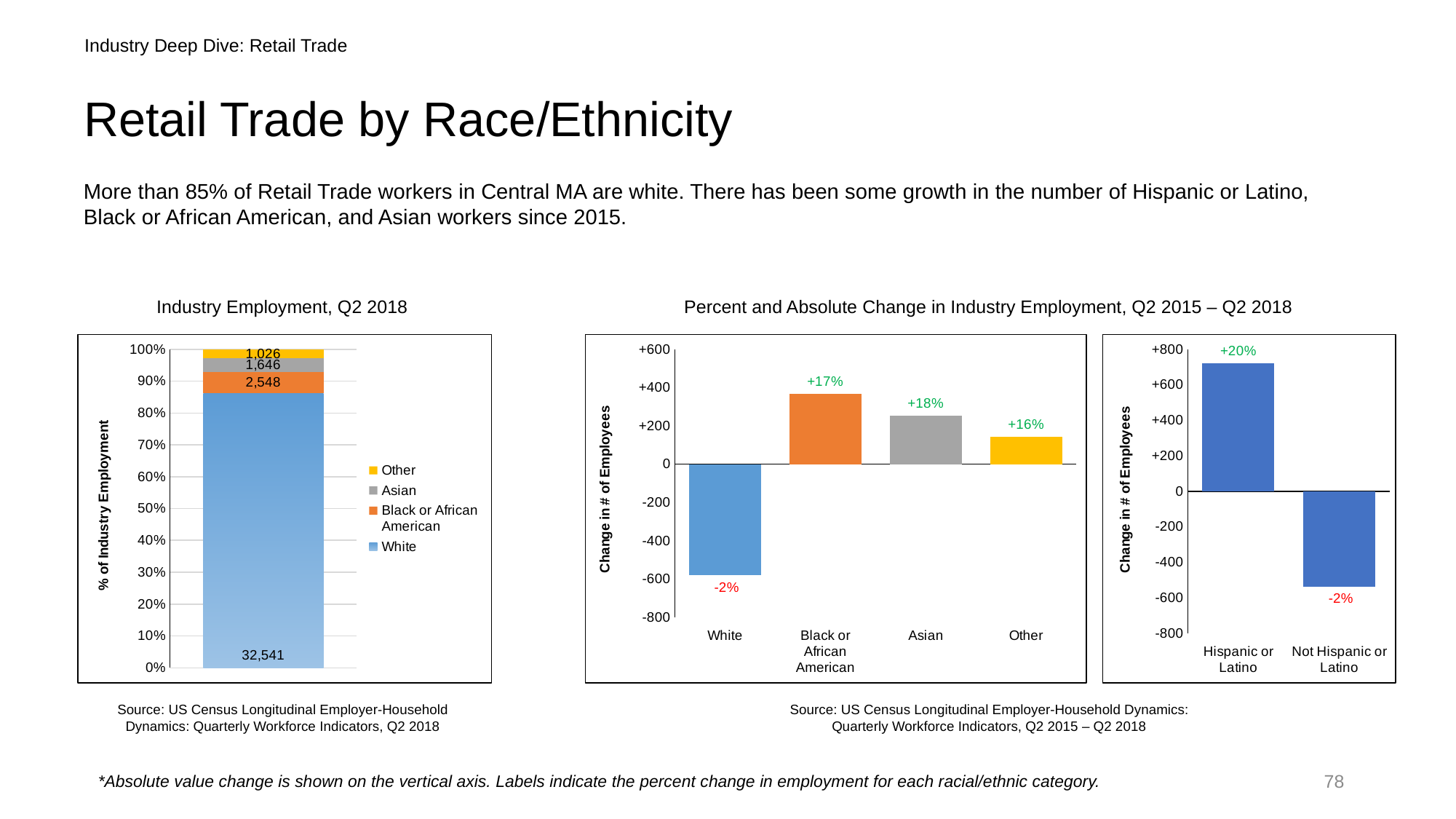
In the middle chart (Percent and Absolute Change in Industry Employment by race), is the value for White greater or less than -400? less In the rightmost chart (Hispanic or Latino vs Not Hispanic or Latino), what percent change label is shown for Hispanic or Latino? +20% In the Industry Employment, Q2 2018 chart, how many White employees are shown? 32,541 In the middle chart (Percent and Absolute Change in Industry Employment by race), what percent change label is shown for Asian? +18% In the Industry Employment, Q2 2018 chart, what is the value for Black or African American? 2,548 How many categories are shown on the x axis of the middle chart (Percent and Absolute Change in Industry Employment by race)? 4 In the Industry Employment, Q2 2018 chart, what is the value for Asian? 1,646 How many series does the legend of the Industry Employment, Q2 2018 chart list? 4 In the rightmost chart (Hispanic or Latino vs Not Hispanic or Latino), is the value for Hispanic or Latino greater or less than +600? greater In the Industry Employment, Q2 2018 chart, what is the total of all four segments in the stacked bar? 37,761 In the middle chart (Percent and Absolute Change in Industry Employment by race), which category has the lowest percent change label? White In the Industry Employment, Q2 2018 chart, what is the difference between the Black or African American value and the Asian value? 902